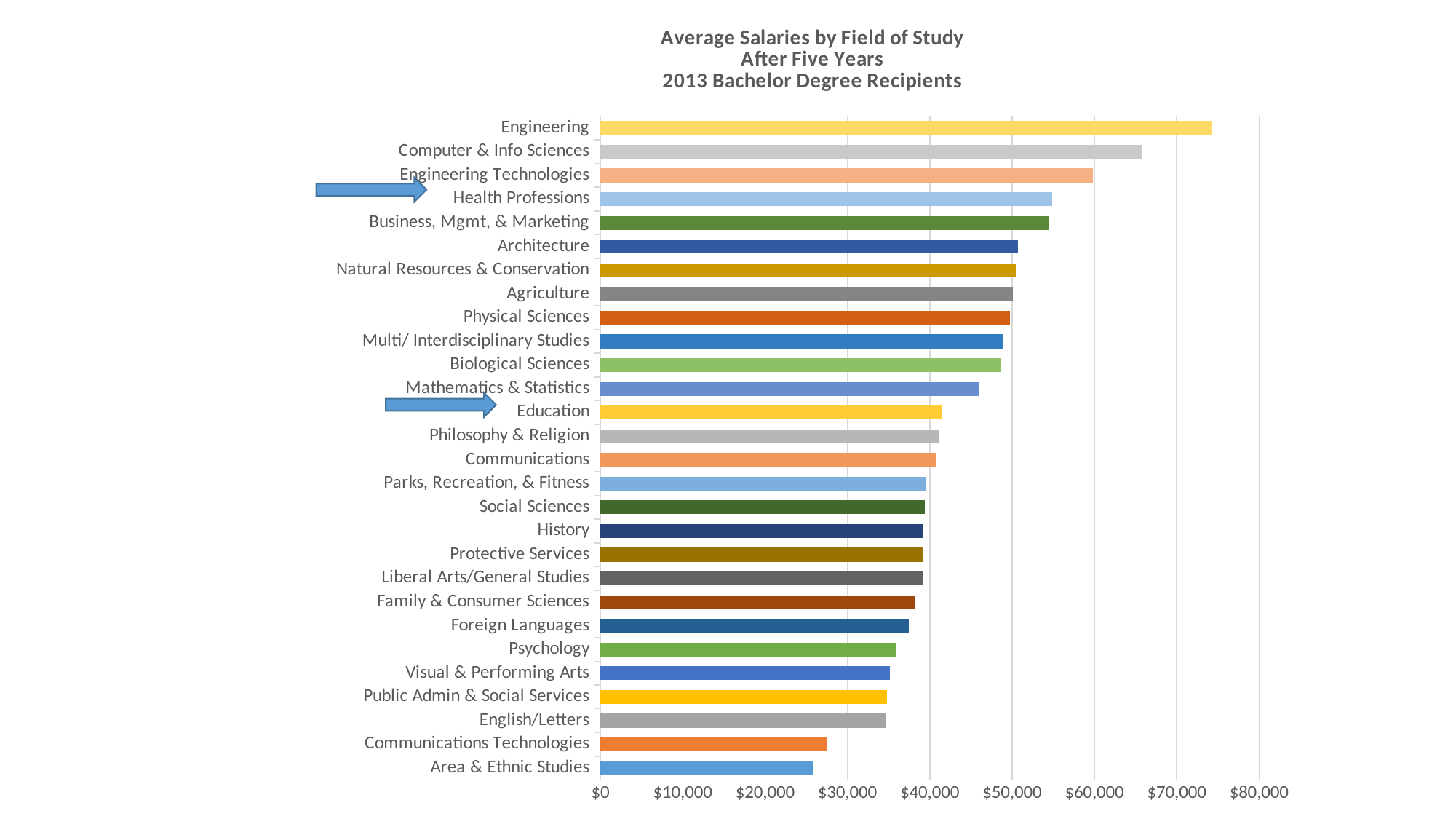
Is the average salary for Engineering greater or less than $70,000? greater What kind of chart is shown on the slide? Bar chart Is the average salary for Psychology greater or less than $40,000? less Which field of study has the lowest average salary? Area & Ethnic Studies Is the average salary for Area & Ethnic Studies greater or less than $30,000? less Which two fields of study do the blue arrows on the slide point to? Health Professions and Education Which has a higher average salary, Health Professions or Education? Health Professions Which field of study has the highest average salary? Engineering How many fields of study are plotted in the chart? 28 Do the bars increase or decrease in value going from the top of the chart to the bottom? Decrease